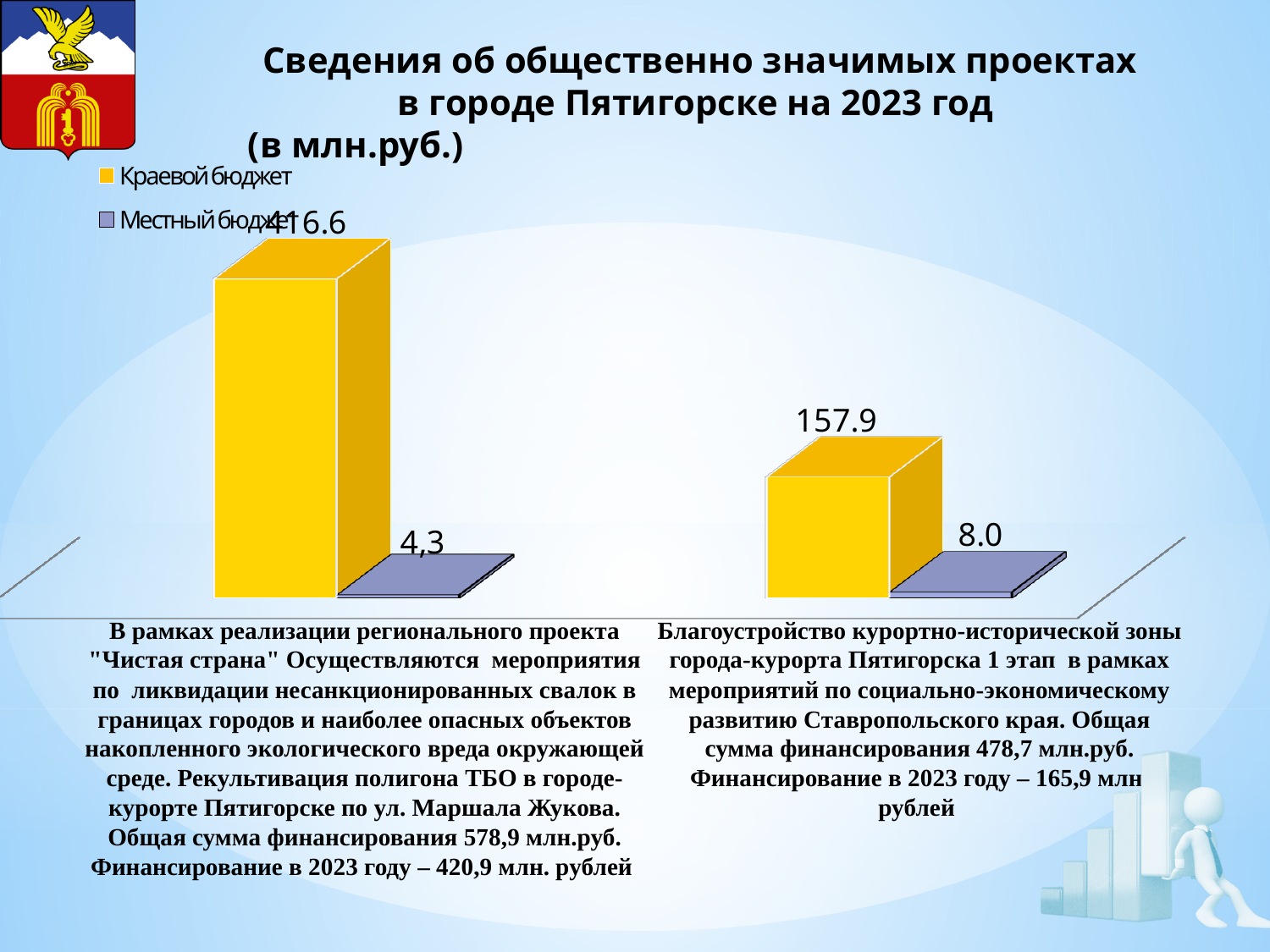
What is the difference between the Краевой бюджет values of the two categories? 258.7 How many series does the legend list? 2 Which colour represents Краевой бюджет in the chart? Yellow What is the value of Местный бюджет for the project "Чистая страна" (the left category)? 4,3 How many categories are shown in the chart? 2 What is the value of Краевой бюджет for the project "Чистая страна" (the left category)? 416.6 Which category has the highest Краевой бюджет value? В рамках реализации регионального проекта "Чистая страна" Which category has the lowest Местный бюджет value? В рамках реализации регионального проекта "Чистая страна" What is the value of Местный бюджет for the category "Благоустройство курортно-исторической зоны" (the right category)? 8.0 Which is larger: the Местный бюджет value for the left category or for the right category? The right category (Благоустройство курортно-исторической зоны) What is the value of Краевой бюджет for the category "Благоустройство курортно-исторической зоны" (the right category)? 157.9 What kind of chart is shown on the slide? Bar chart